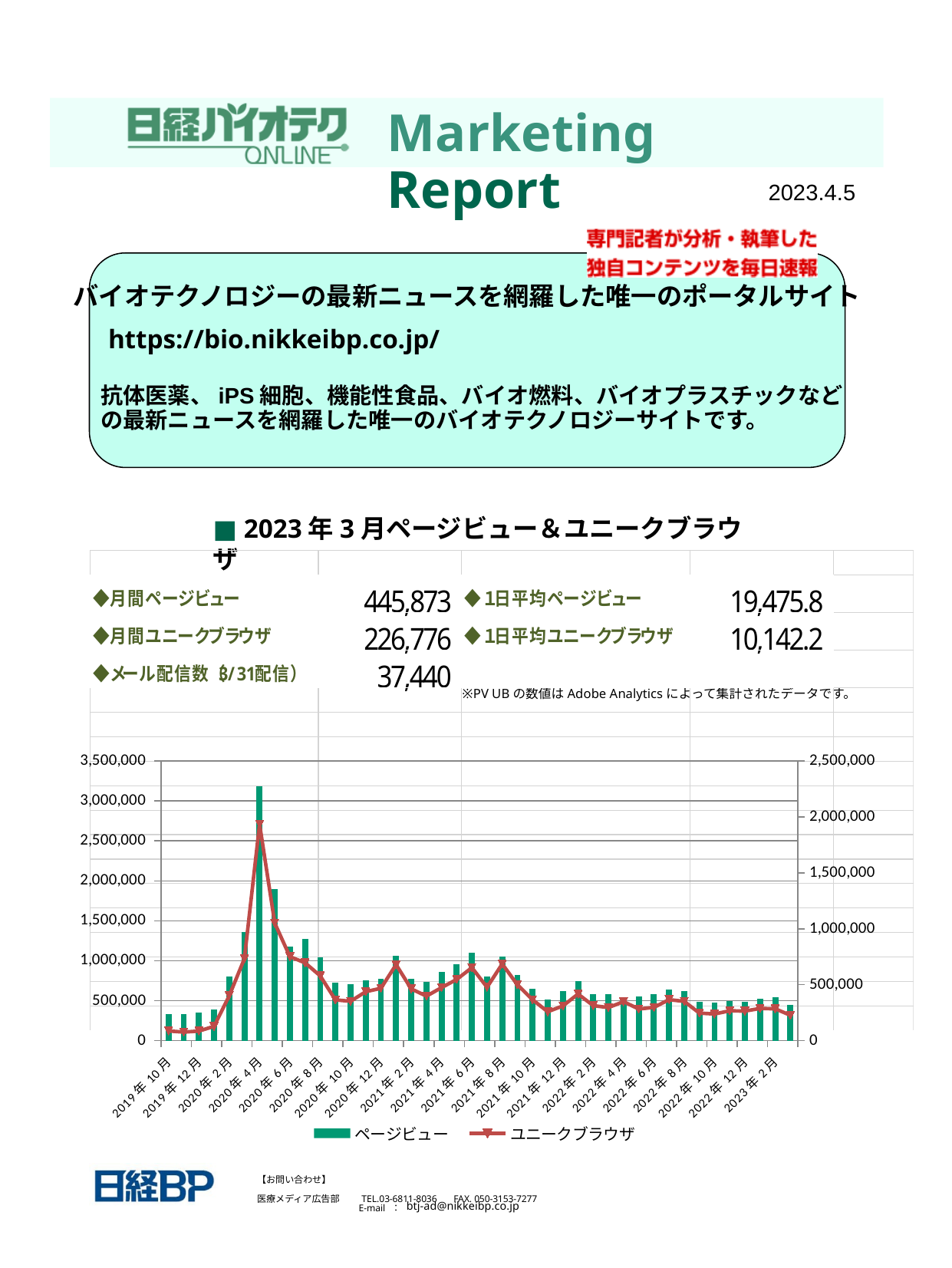
What monthly page view figure (月間ページビュー) is printed above the chart? 445,873 Do page views rise or fall from 2020年4月 to 2020年10月? fall Which month has higher page views, 2020年4月 or 2020年6月? 2020年4月 What are the two series named in the chart legend? ページビュー and ユニークブラウザ In which month do the page views (ページビュー) bars reach their highest value? 2020年4月 How many series does the chart legend list? 2 What is the maximum value shown on the left vertical axis of the chart? 3,500,000 Is the page view value for 2019年10月 greater or less than 500,000? less Is the page view value for 2020年4月 greater or less than 3,000,000? greater What kind of chart is shown at the bottom of the slide? A combined bar and line chart Is the unique browser value for 2020年4月 greater or less than 1,500,000 on the right axis? greater In which month does the unique browser (ユニークブラウザ) line reach its peak? 2020年4月